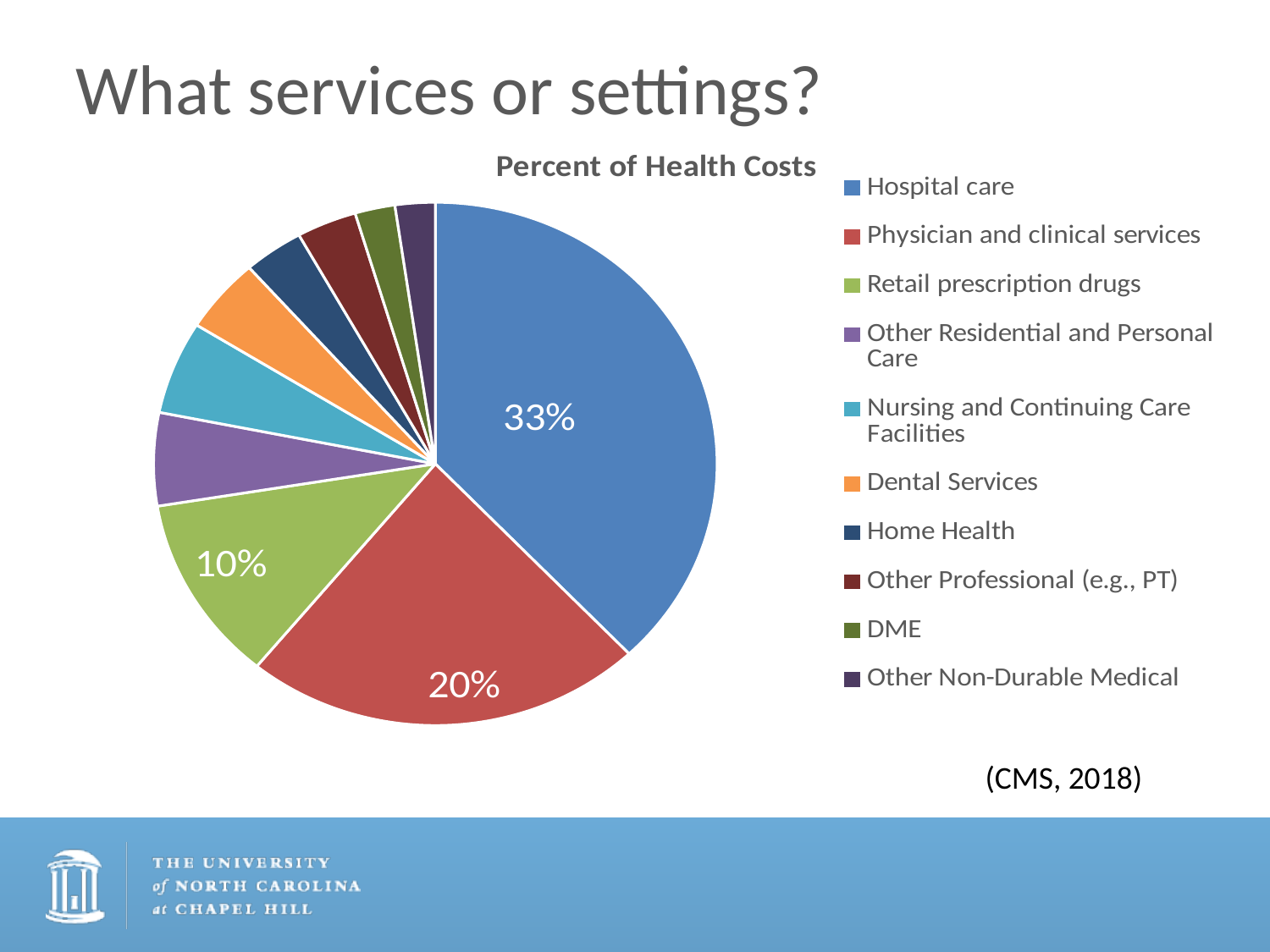
What type of chart is shown on the slide? Pie chart What percentage of health costs is attributed to Hospital care? 33% How many categories does the legend list? 10 What is the difference in percentage points between Hospital care and Physician and clinical services? 13% Which is larger: the share for Retail prescription drugs or the share for Dental Services? Retail prescription drugs What is the title of the chart? Percent of Health Costs What is the difference in percentage points between Physician and clinical services and Retail prescription drugs? 10% Which category accounts for the largest share of health costs? Hospital care What percentage of health costs is attributed to Retail prescription drugs? 10% What colour is the slice for Hospital care? Blue Which is larger: the share for Physician and clinical services or the share for Hospital care? Hospital care What percentage of health costs is attributed to Physician and clinical services? 20%